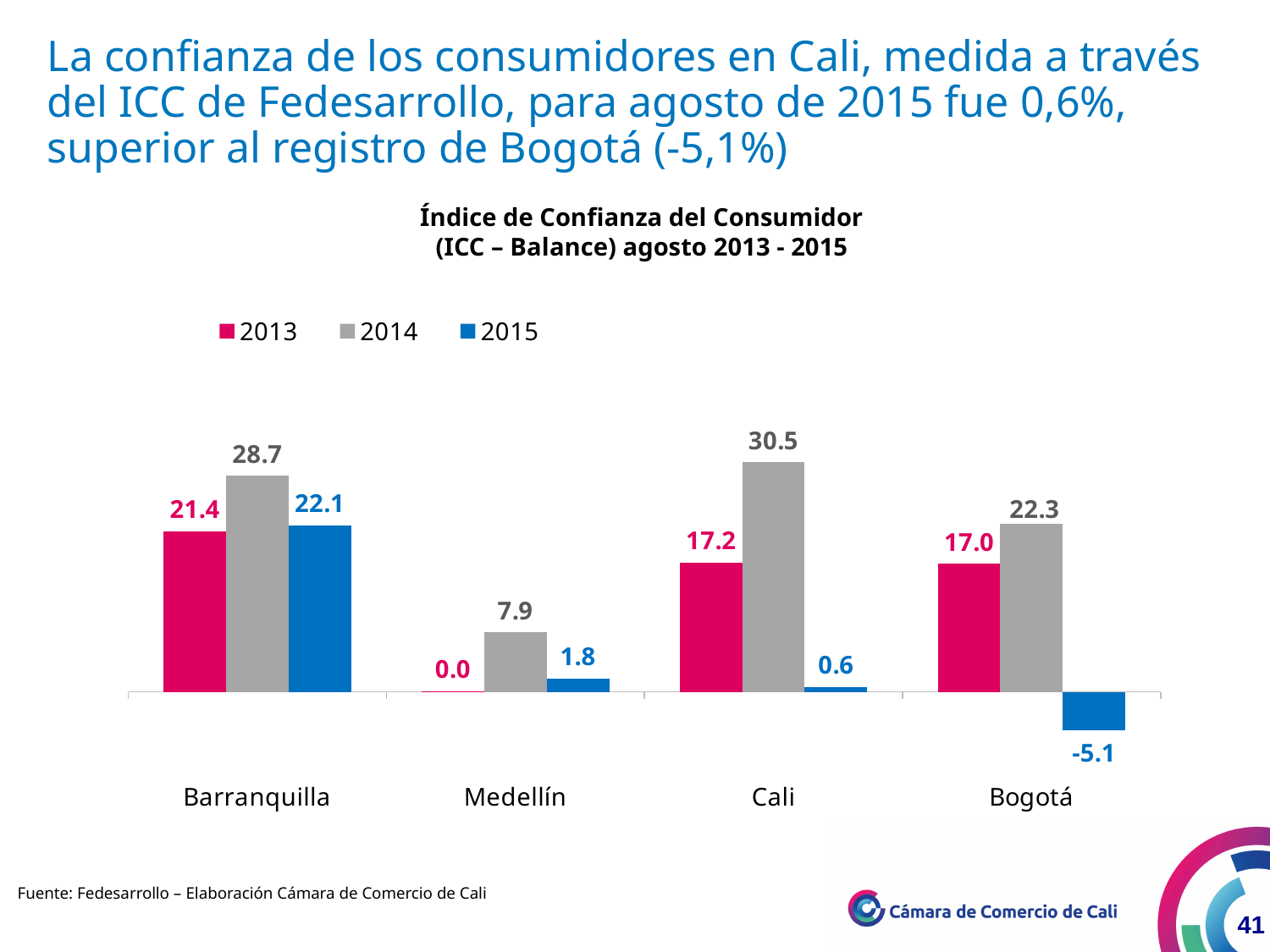
Which city has the highest 2014 value? Cali How many series does the legend list? 3 What is the 2015 value for Cali? 0.6 What is the 2014 value for Barranquilla? 28.7 Which is larger, the 2015 value for Barranquilla or the 2015 value for Medellín? Barranquilla What kind of chart is shown? Bar chart Which colour represents the 2015 series in the legend? Blue How many cities are shown on the x axis? 4 What is the difference between the 2014 and 2013 values for Cali? 13.3 What is the 2013 value for Medellín? 0.0 Which city has the lowest 2015 value? Bogotá What is the 2015 value for Bogotá? -5.1